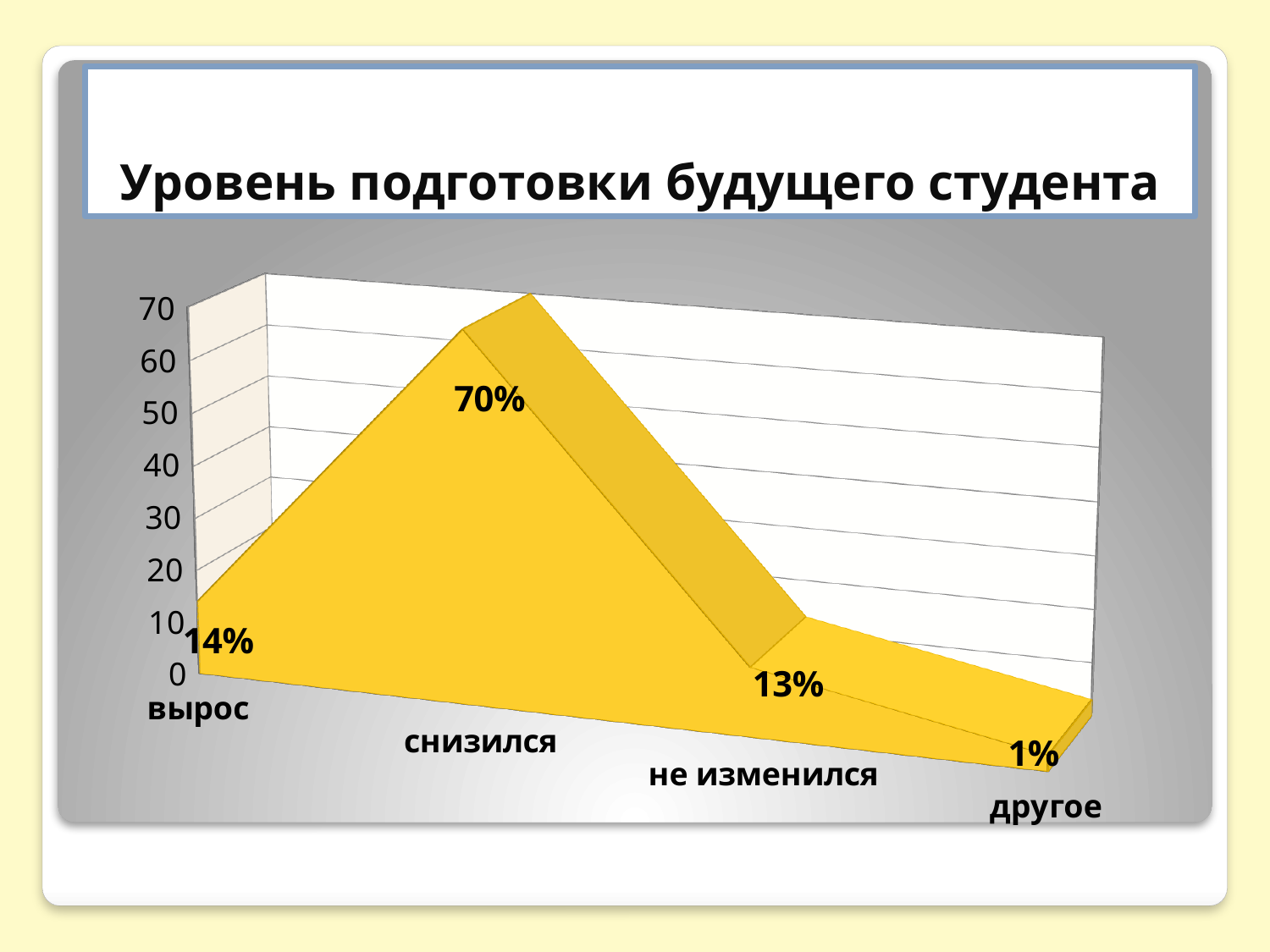
What is the value for не изменился? 13% Which is larger, the value for снизился or the value for не изменился? снизился Which category has the lowest value? другое What is the value for другое? 1% What kind of chart is shown on the slide? area chart What is the difference between the values for вырос and не изменился? 1% What is the value for снизился? 70% What is the difference between the values for снизился and вырос? 56% Which category has the highest value? снизился What is the title of the chart? Уровень подготовки будущего студента What is the value for вырос? 14% How many categories are shown on the x axis? 4